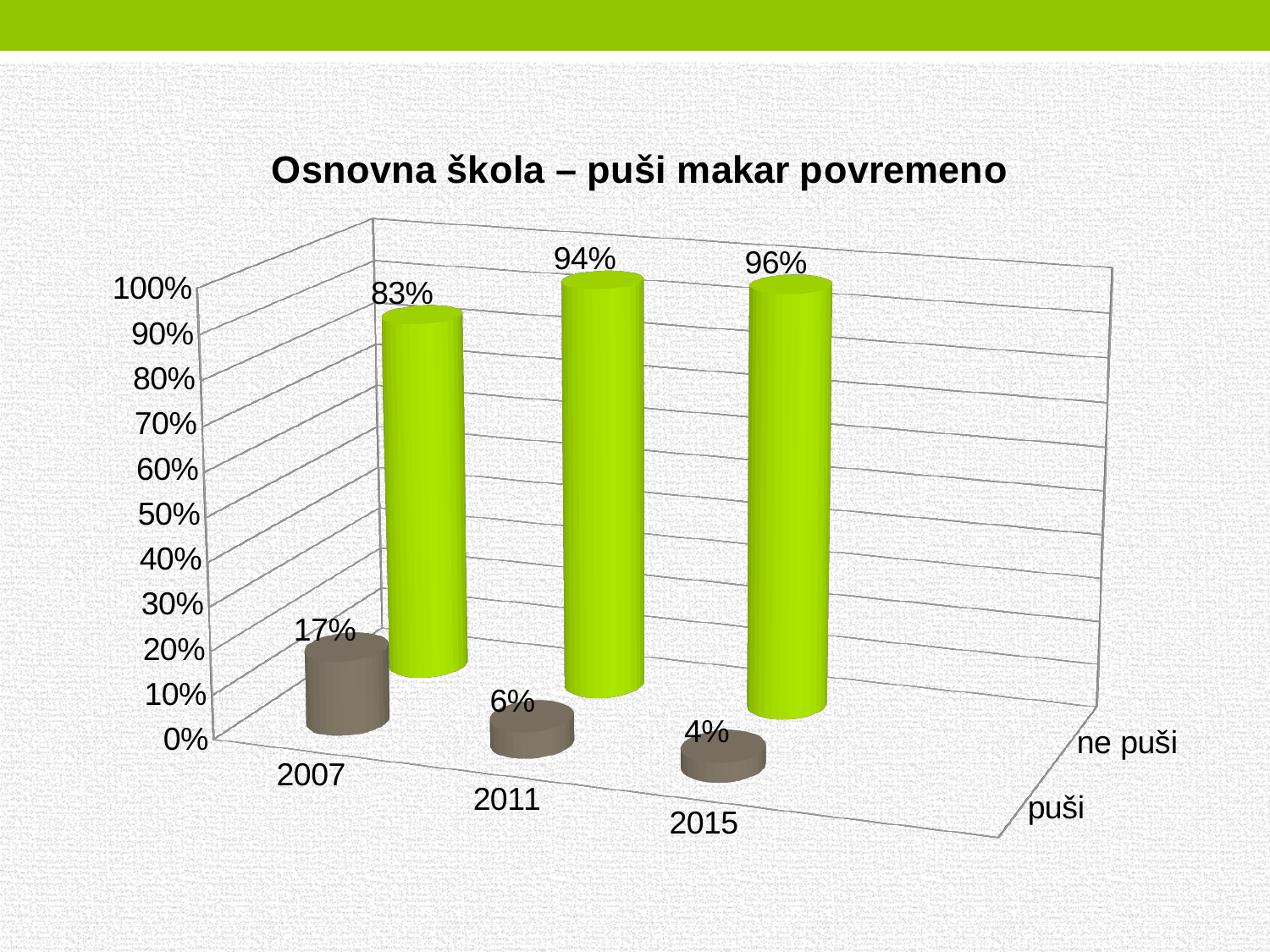
What is the value for "ne puši" in 2015? 96% What is the value for "puši" in 2015? 4% What is the difference between the "ne puši" values for 2015 and 2007? 13% In which year is the "puši" value highest? 2007 Does the "puši" value rise or fall from 2007 to 2015? fall In which year is the "ne puši" value lowest? 2007 Which is larger: the "puši" value in 2011 or in 2015? 2011 What is the value for "ne puši" in 2011? 94% What kind of chart is this? bar chart How many years are shown on the x axis? 3 What is the value for "puši" in 2007? 17% How many series does the chart show? 2